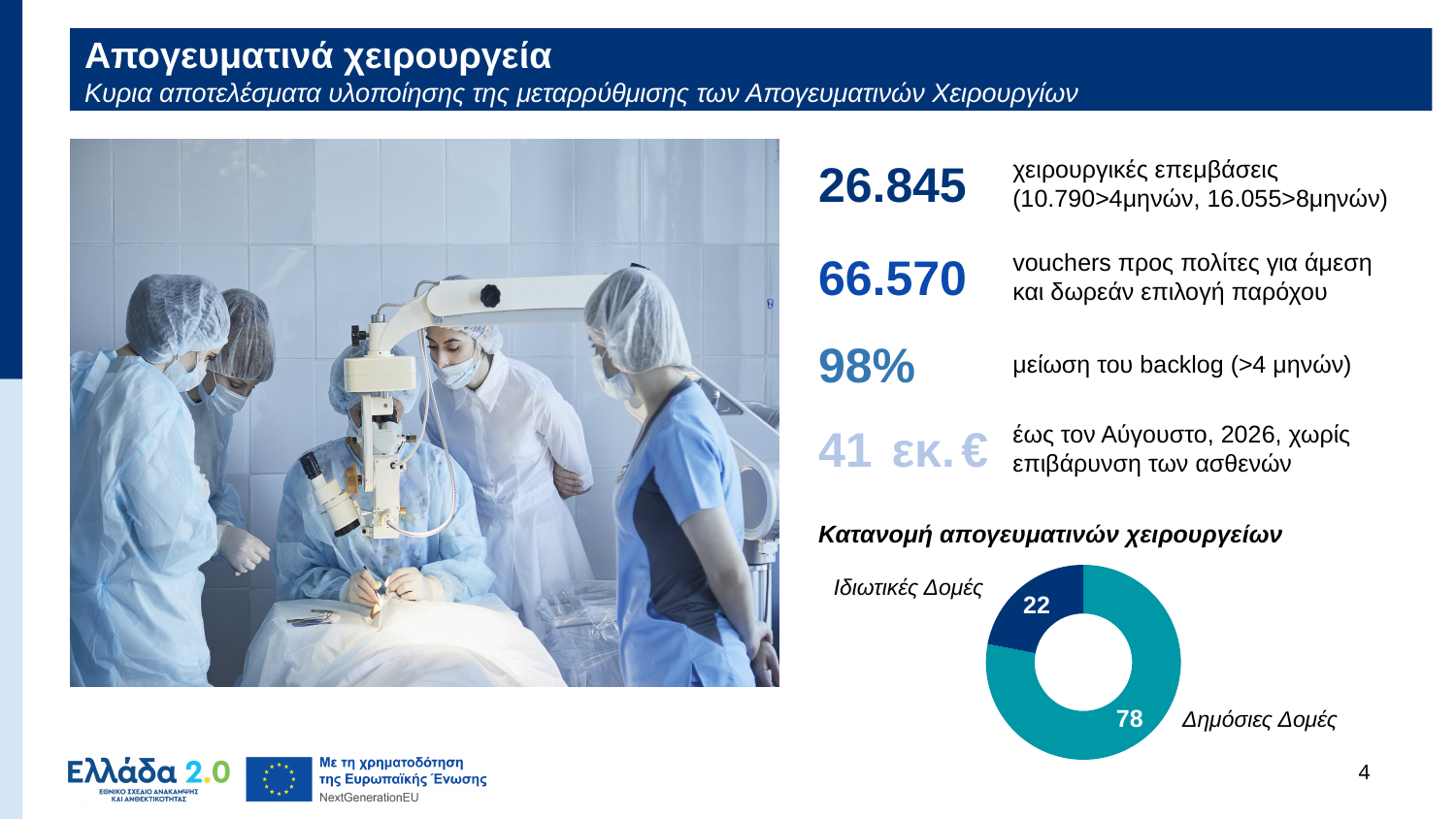
What share of the doughnut chart does Δημόσιες Δομές represent? 78% What is the difference between the values for Δημόσιες Δομές and Ιδιωτικές Δομές in the doughnut chart? 56 Which is larger in the doughnut chart, Ιδιωτικές Δομές or Δημόσιες Δομές? Δημόσιες Δομές What is the total of the two values shown in the doughnut chart? 100 Which category has the largest slice in the doughnut chart? Δημόσιες Δομές What is the value shown for Ιδιωτικές Δομές in the doughnut chart? 22 What kind of chart is shown under the heading 'Κατανομή απογευματινών χειρουργείων'? Doughnut (pie) chart How many categories does the doughnut chart show? 2 What is the value shown for Δημόσιες Δομές in the doughnut chart? 78 Which category has the smallest slice in the doughnut chart? Ιδιωτικές Δομές What share of the doughnut chart does Ιδιωτικές Δομές represent? 22% What is the title written above the doughnut chart? Κατανομή απογευματινών χειρουργείων